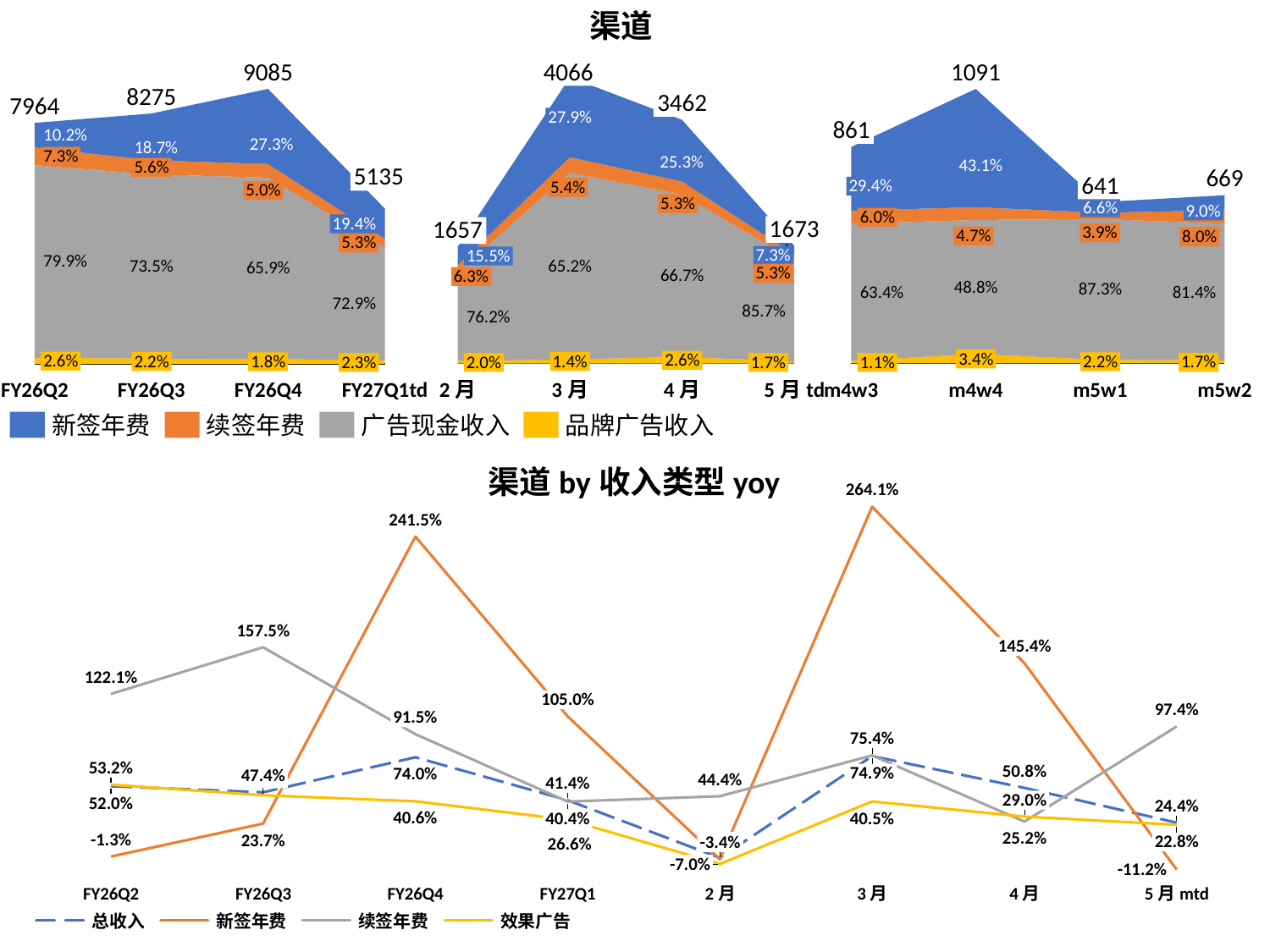
In the top chart titled 渠道, what share does 新签年费 have in m4w4? 43.1% In the bottom chart titled 渠道 by 收入类型 yoy, what is the 续签年费 value for FY26Q3? 157.5% In the top chart titled 渠道, how many series does the legend list? 4 In the top chart titled 渠道, what is the total value shown for FY26Q4? 9085 In the top chart titled 渠道, which of the weekly periods (m4w3, m4w4, m5w1, m5w2) has the lowest total? m5w1 In the top chart titled 渠道, what is the difference between the totals for FY26Q4 and FY26Q3? 810 What kind of chart is the bottom chart titled 渠道 by 收入类型 yoy? line chart In the bottom chart titled 渠道 by 收入类型 yoy, is the 新签年费 value for FY26Q4 larger or smaller than its value for FY27Q1? larger In the top chart titled 渠道, which of the monthly periods (2月, 3月, 4月, 5月td) has the highest total? 3月 In the bottom chart titled 渠道 by 收入类型 yoy, which series reaches the highest value on the chart? 新签年费 In the bottom chart titled 渠道 by 收入类型 yoy, what is the 新签年费 value for 3月? 264.1% In the top chart titled 渠道, what share does 广告现金收入 have in FY26Q2? 79.9%